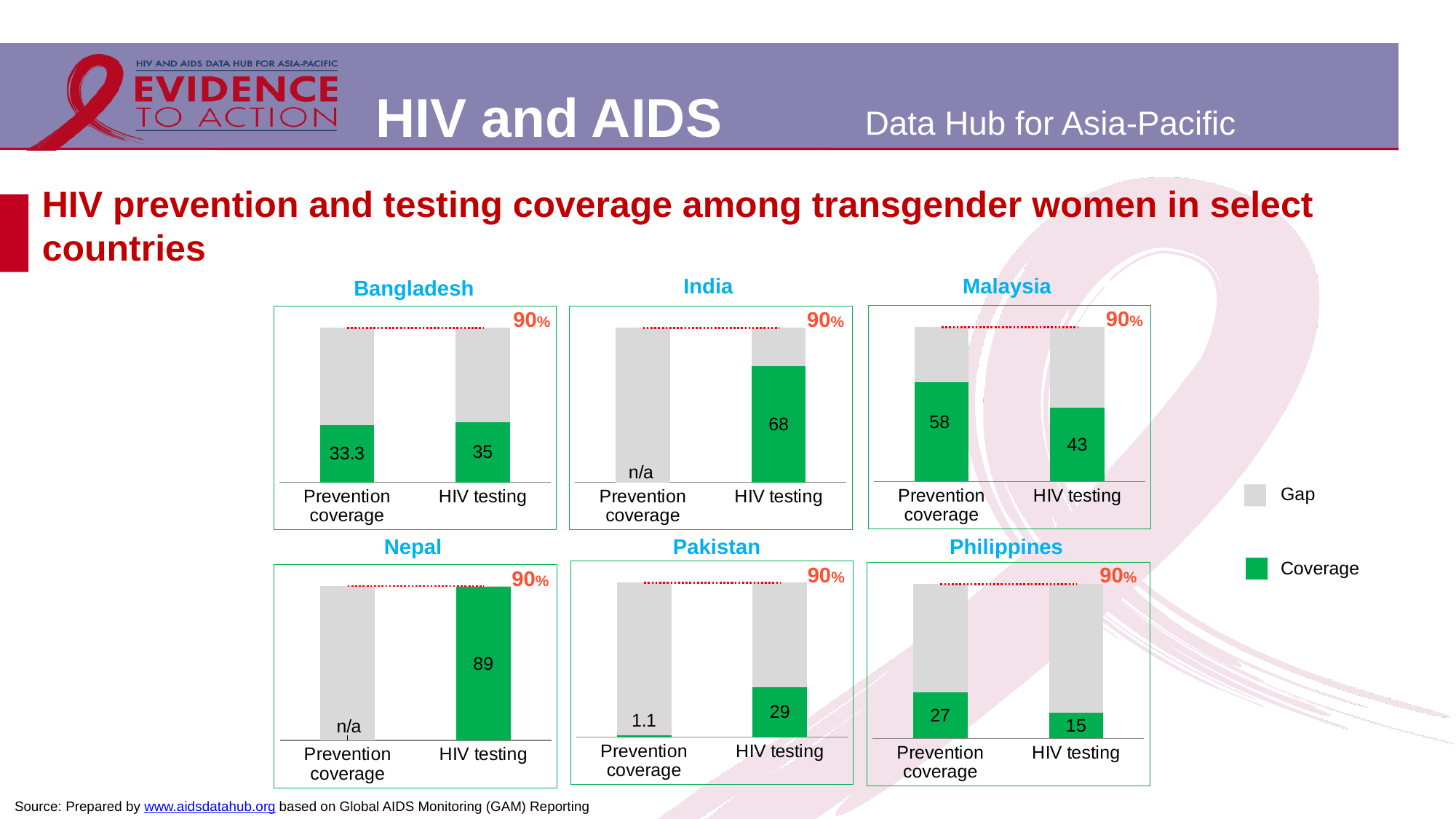
In the India chart, what is the HIV testing coverage value? 68 Across the six charts, which country has the highest HIV testing coverage? Nepal In the Bangladesh chart, what is the prevention coverage value? 33.3 In the Pakistan chart, what is the prevention coverage value? 1.1 In the Malaysia chart, what is the prevention coverage value? 58 Across the six charts, which country has the lowest HIV testing coverage? Philippines What type of chart is used for each country on the slide? Bar chart In the Nepal chart, what is the HIV testing coverage value? 89 In the Philippines chart, what is the HIV testing coverage value? 15 In the Philippines chart, which is larger, prevention coverage or HIV testing coverage? Prevention coverage How many entries does the legend on the slide list? 2 In the Malaysia chart, what is the difference between prevention coverage and HIV testing coverage? 15